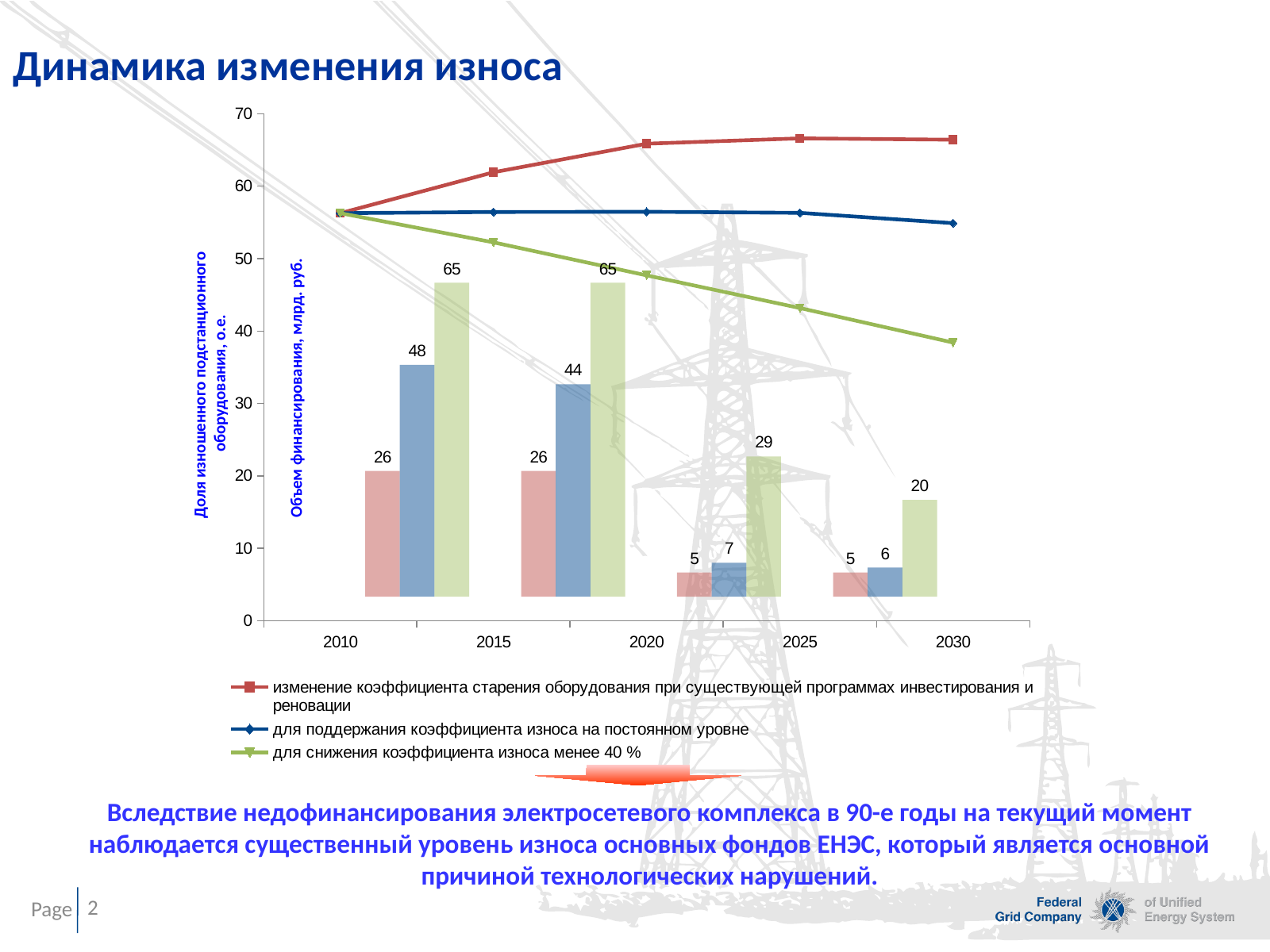
Is the value of the green line (для снижения коэффициента износа менее 40 %) at 2030 greater or less than 40? less How many series does the chart legend list? 3 Does the green line (для снижения коэффициента износа менее 40 %) rise or fall from 2010 to 2030? It falls Which bar has the lowest printed value on the chart? The red bars in the third and fourth groups, 5 What is the value printed on the blue bar in the second group of bars, between 2015 and 2020? 44 What is the difference between the blue bar values in the first group (48) and the second group (44)? 4 What is the value printed on the tallest (green) bar in the first group of bars, between 2010 and 2015? 65 Which is larger: the green bar in the third group of bars (between 2020 and 2025) or the green bar in the fourth group (between 2025 and 2030)? The green bar in the third group (29) What kind of chart is shown on the slide? Combined bar and line chart What is the value printed on the green bar in the last group of bars, between 2025 and 2030? 20 Is the value of the red line (изменение коэффициента старения оборудования при существующей программах инвестирования и реновации) at 2030 greater or less than 60? greater What is the title of the chart? Динамика изменения износа